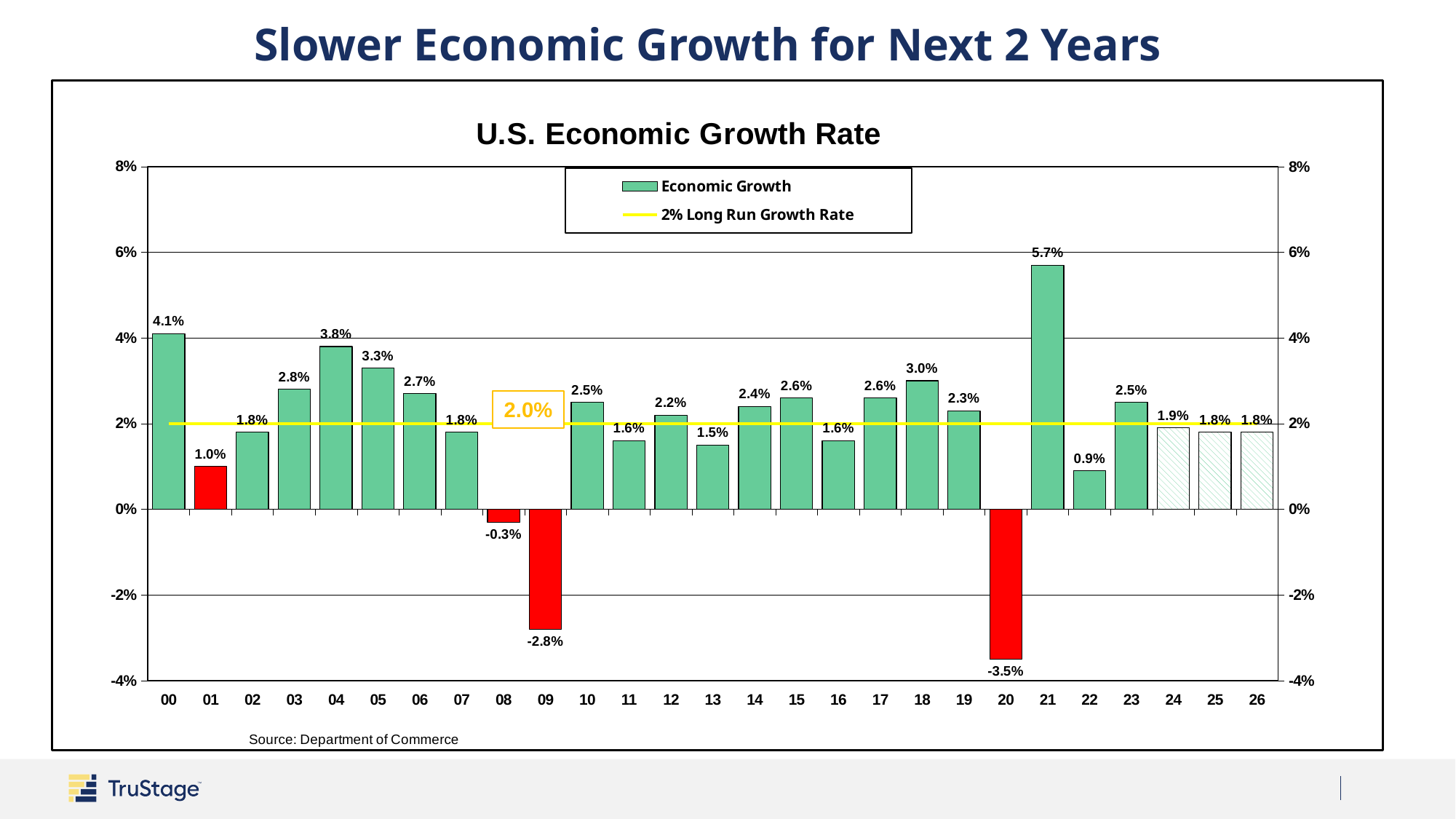
Which year has the highest economic growth rate on the chart? 21 What kind of chart is used to show the U.S. Economic Growth Rate? Bar chart Which year has the lowest economic growth rate on the chart? 20 Which year has a higher growth rate, 04 or 05? 04 What is the economic growth rate shown for 24? 1.9% What is the U.S. economic growth rate shown for 21? 5.7% What value does the yellow horizontal line represent? 2.0% What is the difference between the growth rate in 21 and the growth rate in 22? 4.8% What is the economic growth rate shown for 09? -2.8% How many series does the legend list? 2 How many years are shown on the x axis of the chart? 27 What is the title of the chart? U.S. Economic Growth Rate